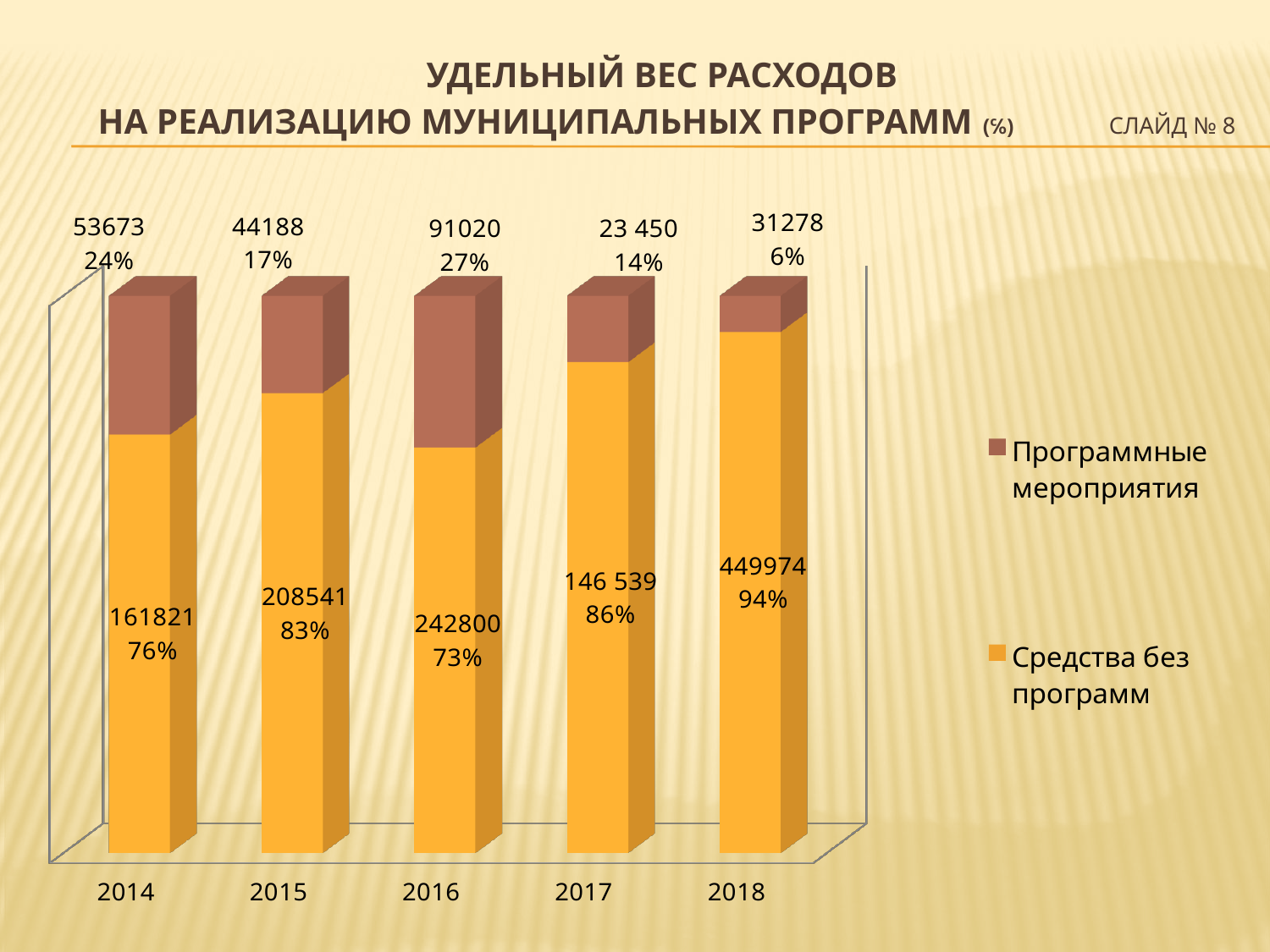
What is the value for Средства без программ in 2018? 449974 What is the total of the two values in the 2014 bar? 215494 What percentage share does Программные мероприятия have in 2014? 24% What is the difference in percentage points between the share of Программные мероприятия in 2016 and in 2018? 21 What kind of chart is shown on the slide? Stacked bar chart Which is larger: the value for Средства без программ in 2015 or in 2016? 2016 In which year is the share of Программные мероприятия the highest? 2016 What is the value for Средства без программ in 2017? 146 539 How many series does the legend list? 2 In which year is the share of Программные мероприятия the lowest? 2018 What is the value for Программные мероприятия in 2016? 91020 How many years are shown on the x axis? 5